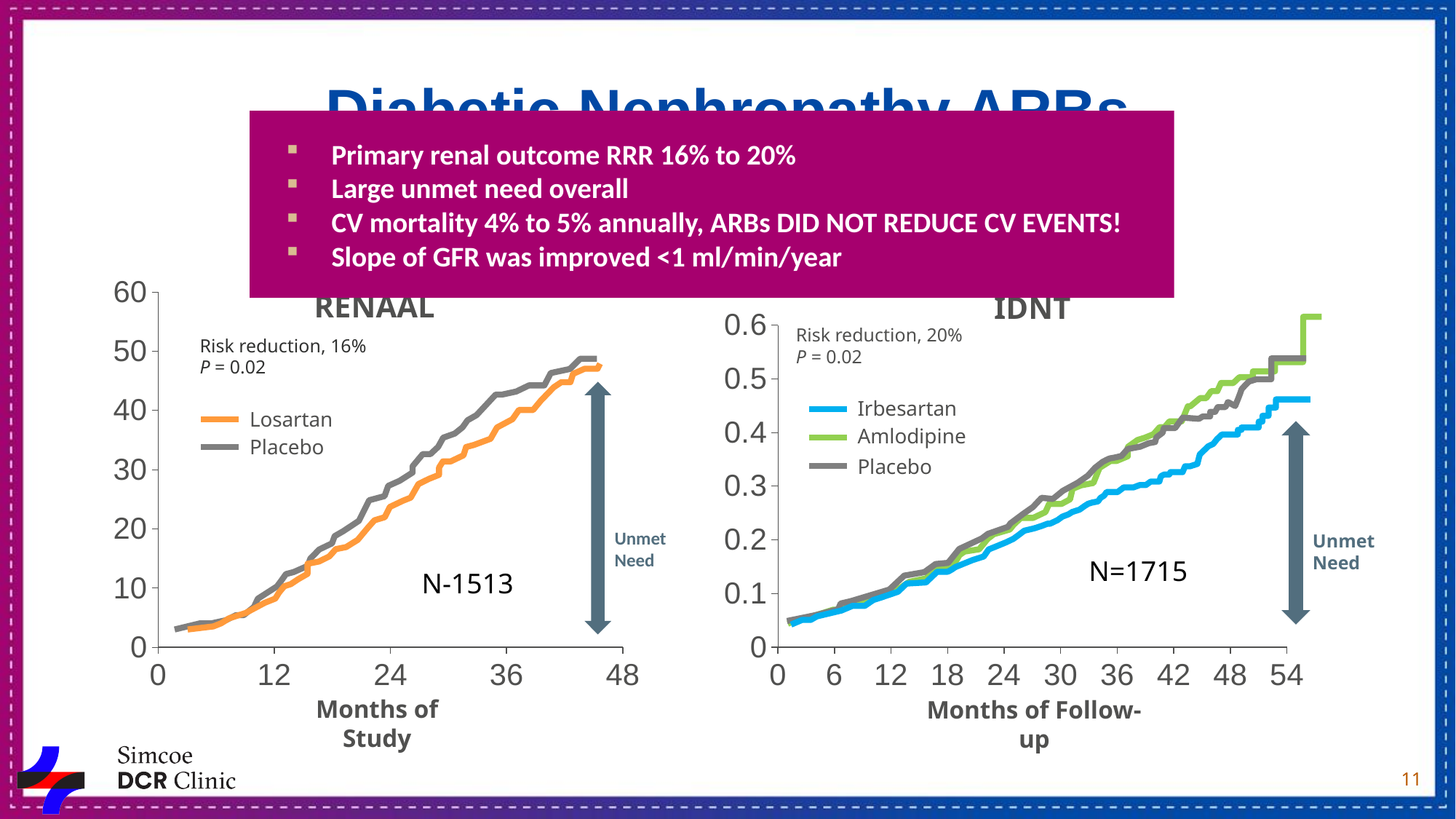
In the IDNT chart on the right, which series is higher at 48 months, Irbesartan or Amlodipine? Amlodipine In the RENAAL chart on the left, is the Placebo value at 36 months greater or less than 40? greater In the IDNT chart on the right, is the Amlodipine value at 42 months greater or less than 0.4? greater How many series does the legend of the RENAAL chart on the left list? 2 What is the x-axis label of the IDNT chart on the right? Months of Follow-up In the IDNT chart on the right, is the Irbesartan value at 42 months greater or less than 0.3? greater What risk reduction is annotated on the RENAAL chart on the left? 16% In the RENAAL chart on the left, do the values rise or fall as months of study increase? rise How many series does the legend of the IDNT chart on the right list? 3 What kind of chart is the RENAAL chart on the left? line chart In the RENAAL chart on the left, which series is higher at 36 months, Losartan or Placebo? Placebo